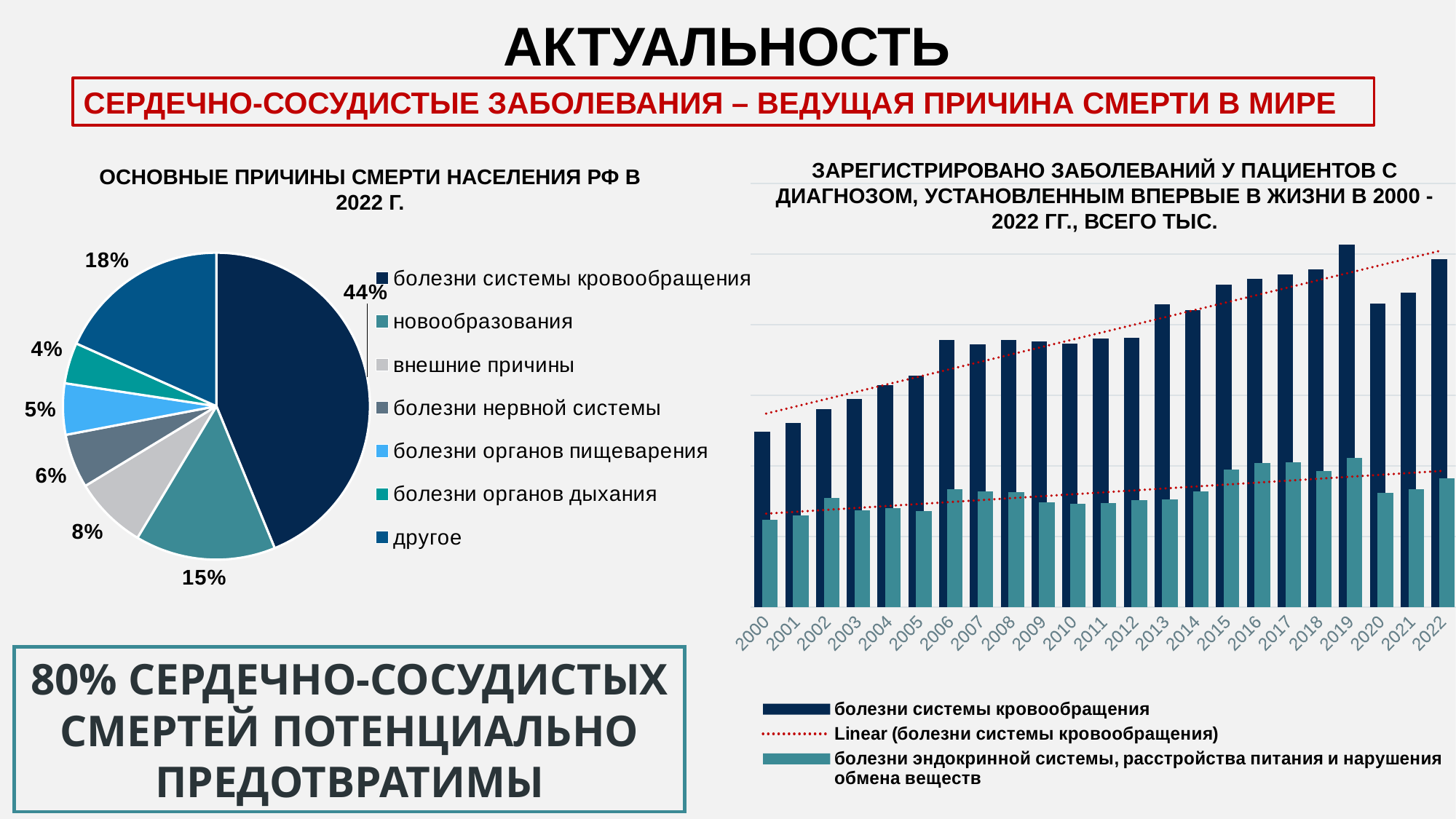
On the pie chart 'Основные причины смерти населения РФ в 2022 г.', which category has the largest slice? болезни системы кровообращения On the pie chart 'Основные причины смерти населения РФ в 2022 г.', what share is shown for 'новообразования'? 15% On the pie chart 'Основные причины смерти населения РФ в 2022 г.', what share is shown for 'другое'? 18% On the pie chart 'Основные причины смерти населения РФ в 2022 г.', how many categories are shown? 7 On the bar chart on the right of the slide, how many years are shown on the x axis? 23 On the bar chart on the right of the slide, do the values for 'болезни системы кровообращения' generally rise or fall from 2000 to 2022? rise On the pie chart 'Основные причины смерти населения РФ в 2022 г.', which is larger: 'внешние причины' or 'болезни нервной системы'? внешние причины On the pie chart 'Основные причины смерти населения РФ в 2022 г.', what is the difference between the shares for 'болезни системы кровообращения' and 'новообразования'? 29% What kind of chart is the chart on the right of the slide, 'Зарегистрировано заболеваний у пациентов с диагнозом, установленным впервые в жизни в 2000 - 2022 гг., всего тыс.'? bar chart On the pie chart 'Основные причины смерти населения РФ в 2022 г.', which category has the smallest slice? болезни органов дыхания On the bar chart on the right of the slide, in which year is the bar for 'болезни системы кровообращения' highest? 2019 On the pie chart 'Основные причины смерти населения РФ в 2022 г.', what share is shown for 'болезни системы кровообращения'? 44%